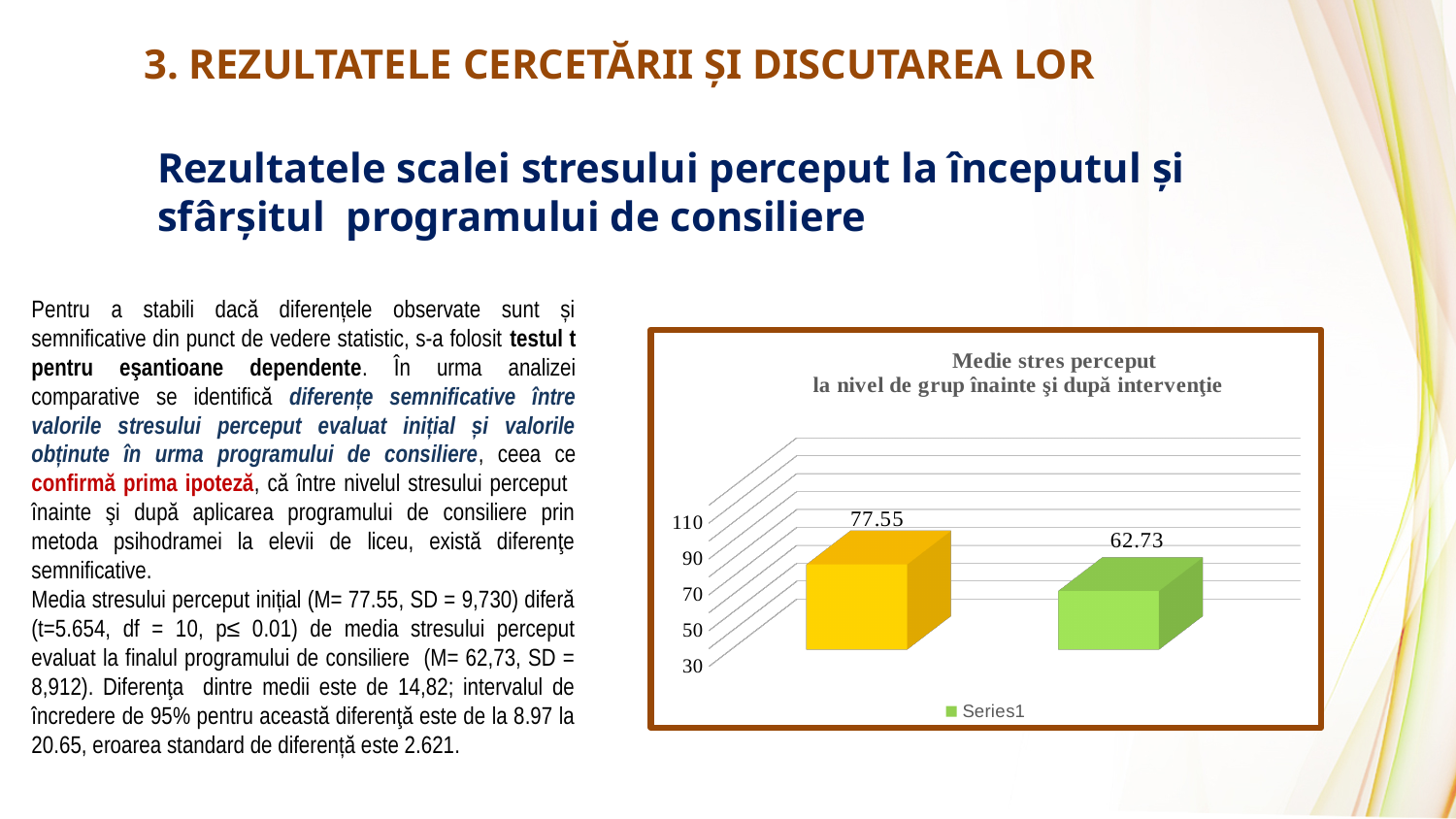
What is the name of the series shown in the chart legend? Series1 Is the value of the yellow bar greater or less than 70? greater Which bar has the lowest value, the left (yellow) bar or the right (green) bar? the right (green) bar What kind of chart is shown on the slide? bar chart Which bar has the highest value, the left (yellow) bar or the right (green) bar? the left (yellow) bar What is the value shown on the left (yellow) bar of the chart? 77.55 What is the value shown on the right (green) bar of the chart? 62.73 How many bars are plotted in the chart? 2 Is the value of the yellow bar larger or smaller than the value of the green bar? larger What is the difference between the value of the left bar and the value of the right bar? 14.82 How many series does the chart legend list? 1 Is the value of the green bar greater or less than 70? less